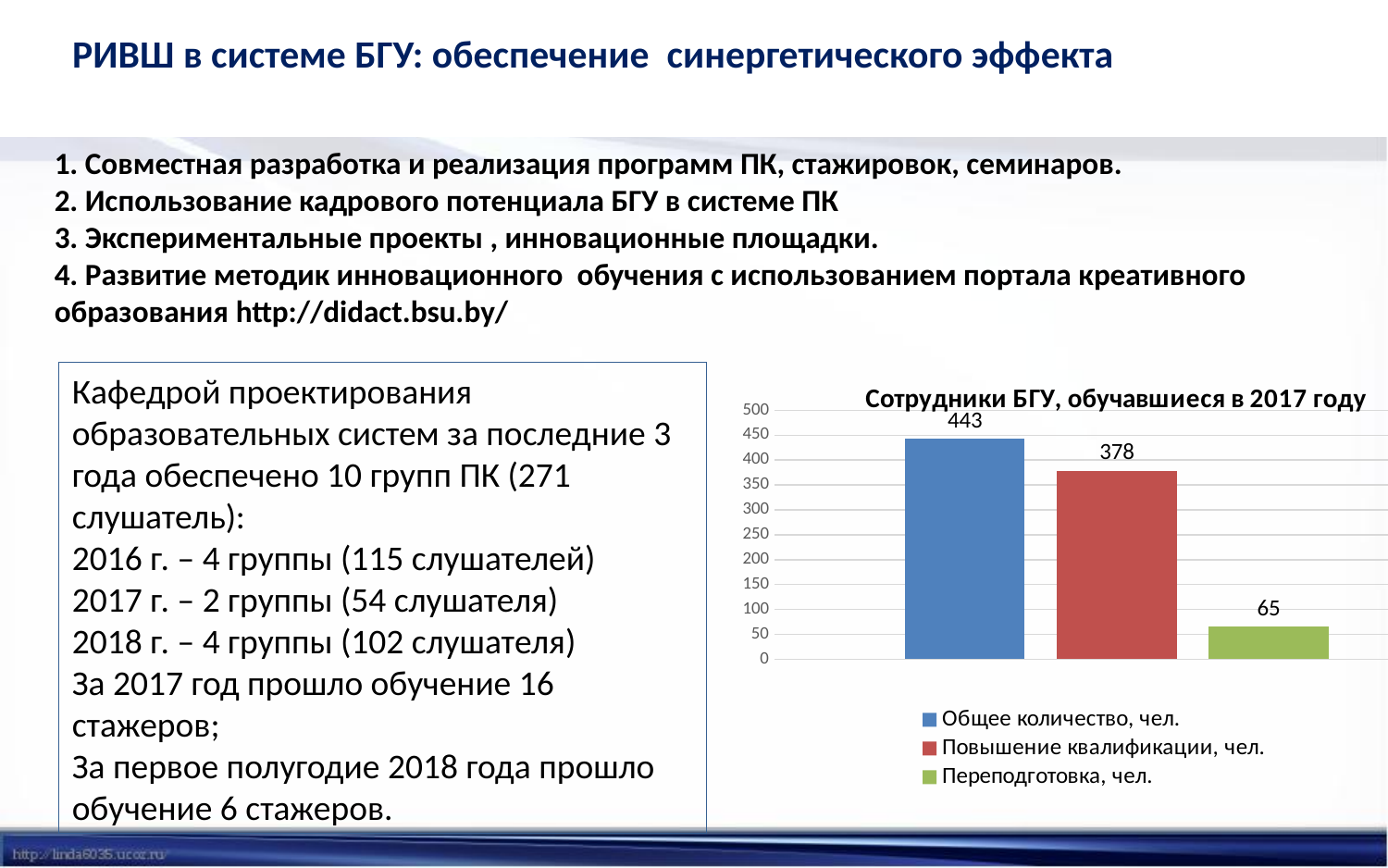
How many series does the legend list? 3 Which series has the highest value in the chart? Общее количество, чел. What is the difference between 'Общее количество, чел.' and 'Повышение квалификации, чел.'? 65 What kind of chart is shown on the slide? bar chart Which is larger: 'Повышение квалификации, чел.' or 'Переподготовка, чел.'? Повышение квалификации, чел. What is the value for 'Общее количество, чел.' in the chart? 443 What is the difference between 'Повышение квалификации, чел.' and 'Переподготовка, чел.'? 313 What is the value for 'Повышение квалификации, чел.' in the chart? 378 What is the value for 'Переподготовка, чел.' in the chart? 65 Is the value for 'Переподготовка, чел.' greater or less than 100? less Which series has the lowest value in the chart? Переподготовка, чел. What is the title of the chart? Сотрудники БГУ, обучавшиеся в 2017 году